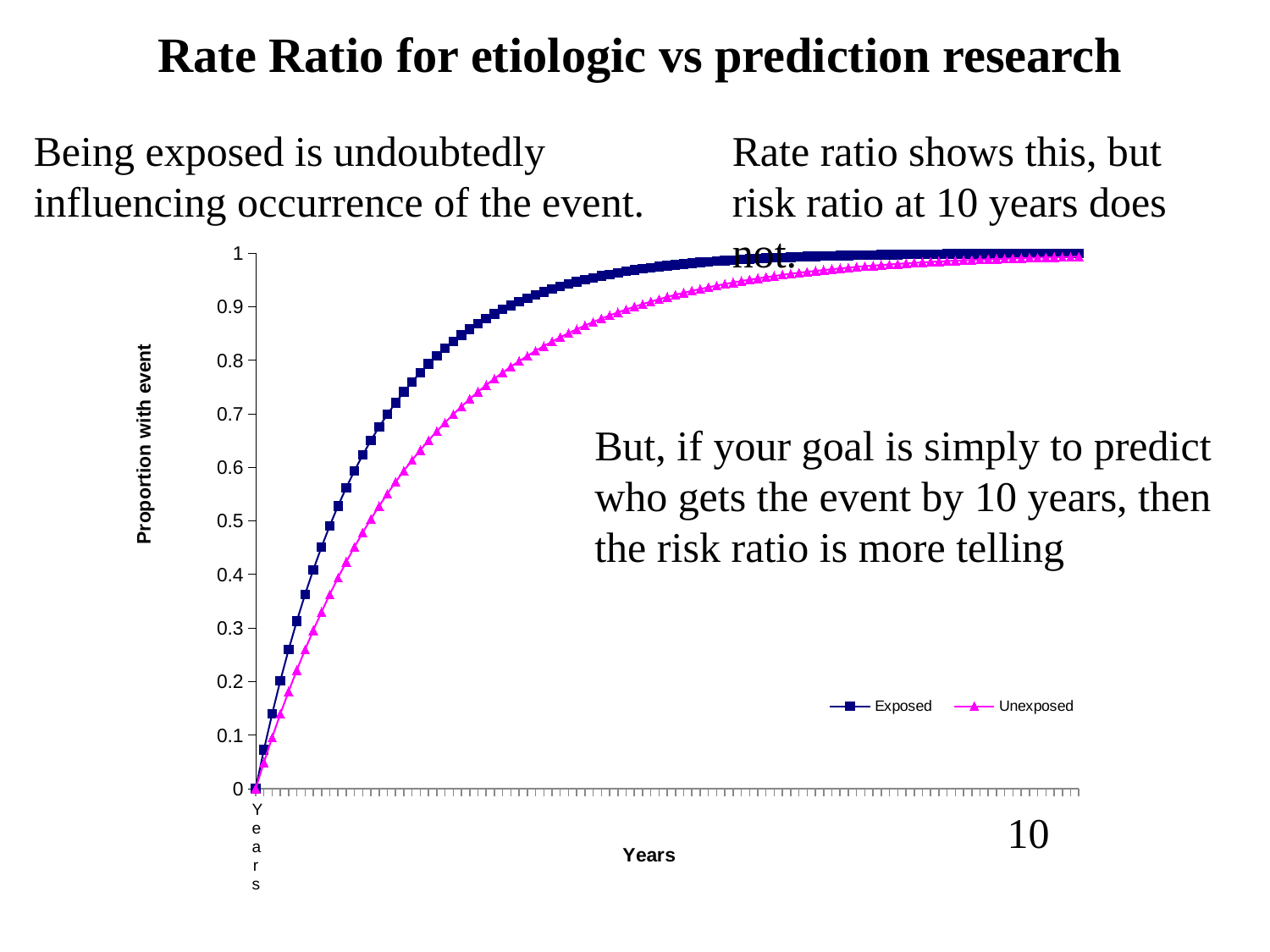
Do the values for the Unexposed series rise or fall along the x axis? rise Which two series are listed in the chart's legend? Exposed and Unexposed Is the value for the Unexposed series at the midpoint of the x axis greater or less than 0.5? greater What kind of chart is shown on the slide? line chart Which series has the higher proportion with event in the early years, Exposed or Unexposed? Exposed Is the value for the Exposed series at the right end of the x axis greater or less than 0.9? greater What is the title of the chart's vertical axis? Proportion with event Which series rises more steeply at the start of the chart, Exposed or Unexposed? Exposed Is the value for the Unexposed series at the right end of the x axis greater or less than 0.9? greater Do the values for the Exposed series rise or fall as years increase along the x axis? rise How many series does the chart's legend list? 2